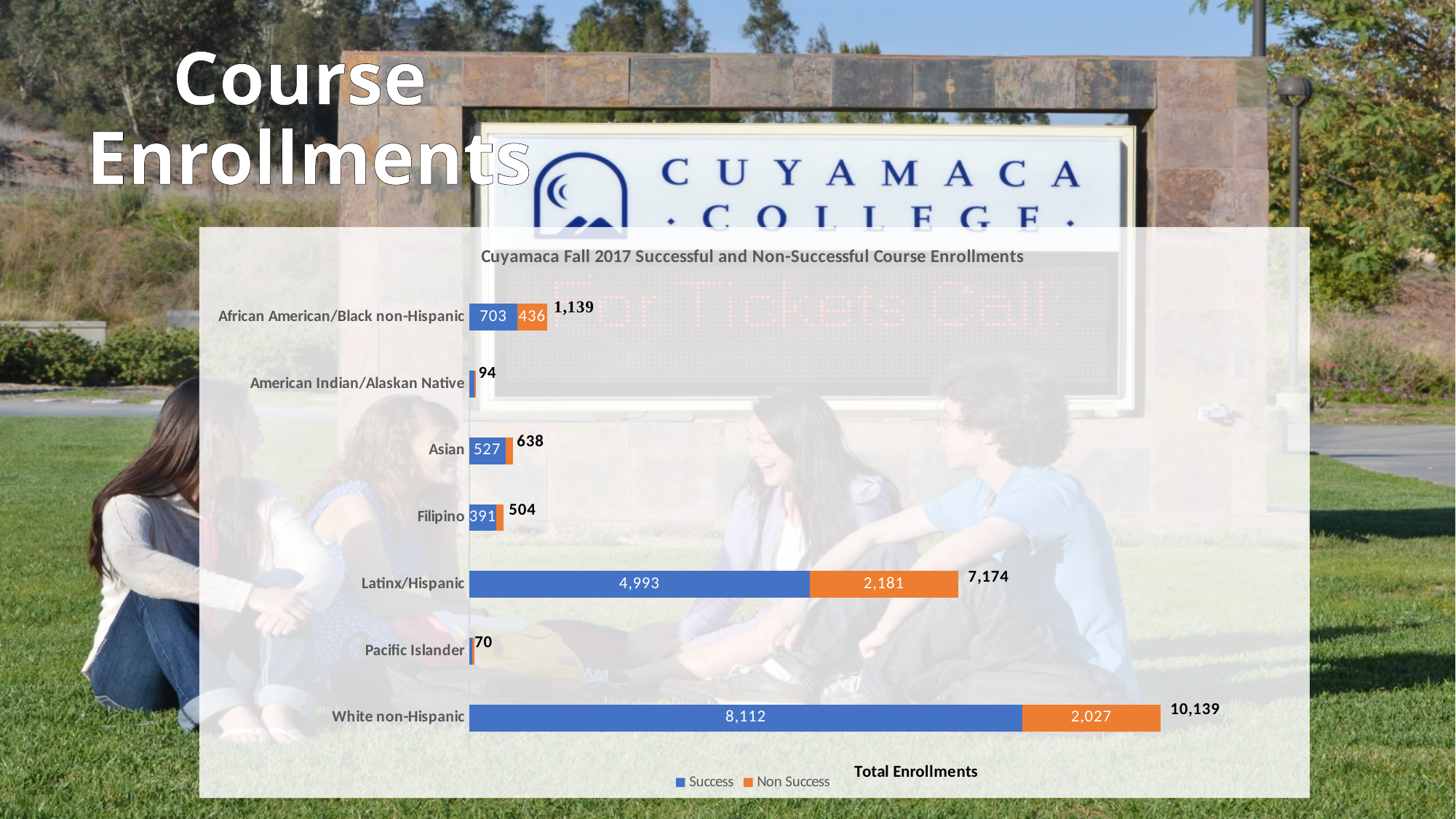
Which category has the lowest total enrollments? Pacific Islander What is the Non Success value for Latinx/Hispanic? 2,181 How many categories are shown on the chart? 7 Which category has the highest total enrollments? White non-Hispanic What is the total enrollment shown for Pacific Islander? 70 What kind of chart is shown on the slide? Stacked bar chart What is the title of the chart? Cuyamaca Fall 2017 Successful and Non-Successful Course Enrollments What is the difference between the Success values for White non-Hispanic and Latinx/Hispanic? 3,119 What is the Success value for White non-Hispanic? 8,112 How many series does the legend list? 2 Which is larger, the Non Success value for Latinx/Hispanic or for White non-Hispanic? Latinx/Hispanic What is the total enrollment shown for African American/Black non-Hispanic? 1,139